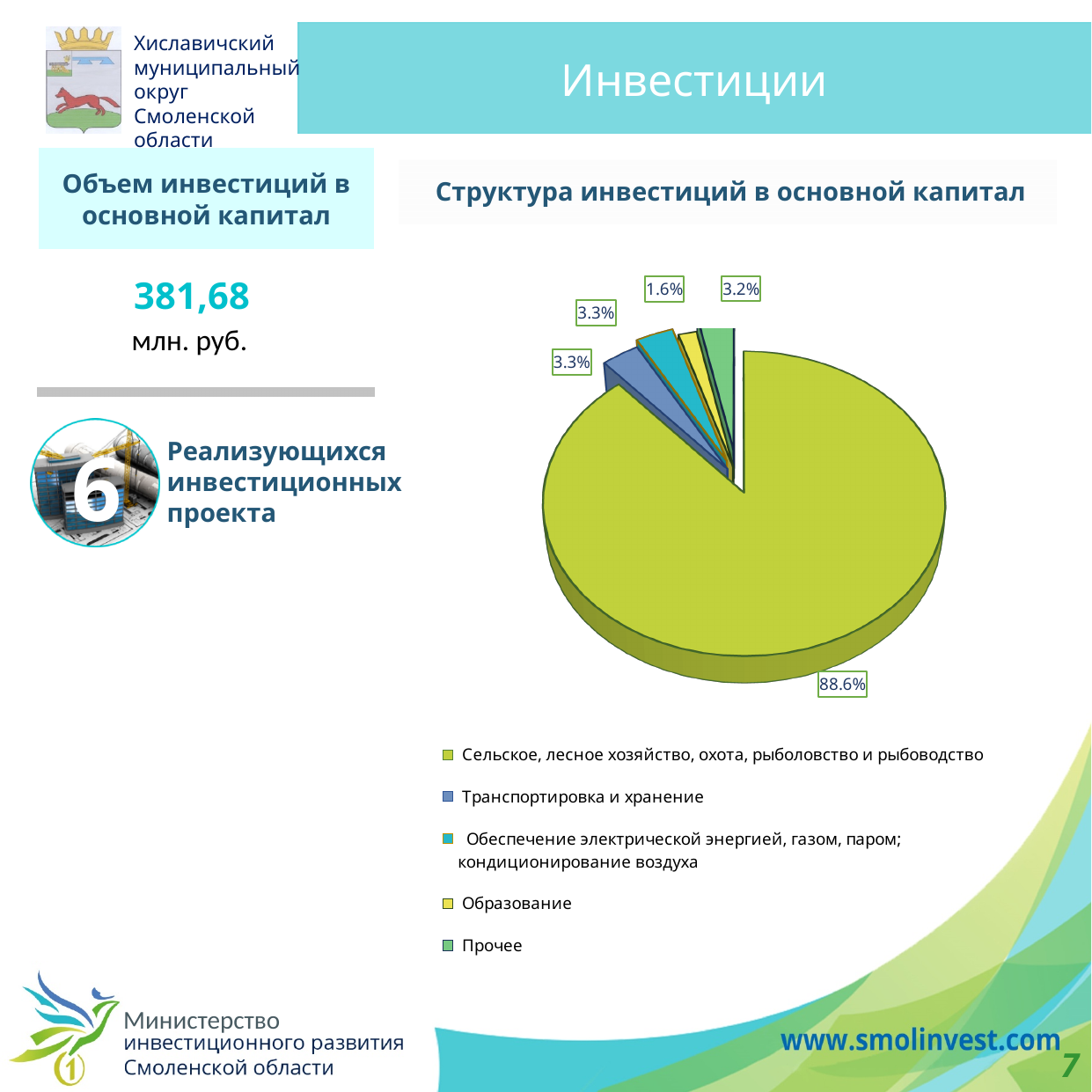
Which is larger in the pie chart: the share for "Образование" or the share for "Прочее"? Прочее How many entries does the legend of the pie chart list? 5 What is the value shown for "Транспортировка и хранение" in the pie chart? 3.3% How many slices does the pie chart have? 5 What is the value shown for "Прочее" in the pie chart? 3.2% Which category has the largest slice in the pie chart? Сельское, лесное хозяйство, охота, рыболовство и рыбоводство What is the value shown for "Образование" in the pie chart? 1.6% What kind of chart is shown under the title "Структура инвестиций в основной капитал"? pie chart By how many percentage points does the share for "Сельское, лесное хозяйство, охота, рыболовство и рыбоводство" exceed the share for "Прочее"? 85.4 What is the title of the pie chart on the slide? Структура инвестиций в основной капитал Which category has the smallest slice in the pie chart? Образование What share of the pie does "Сельское, лесное хозяйство, охота, рыболовство и рыбоводство" have? 88.6%